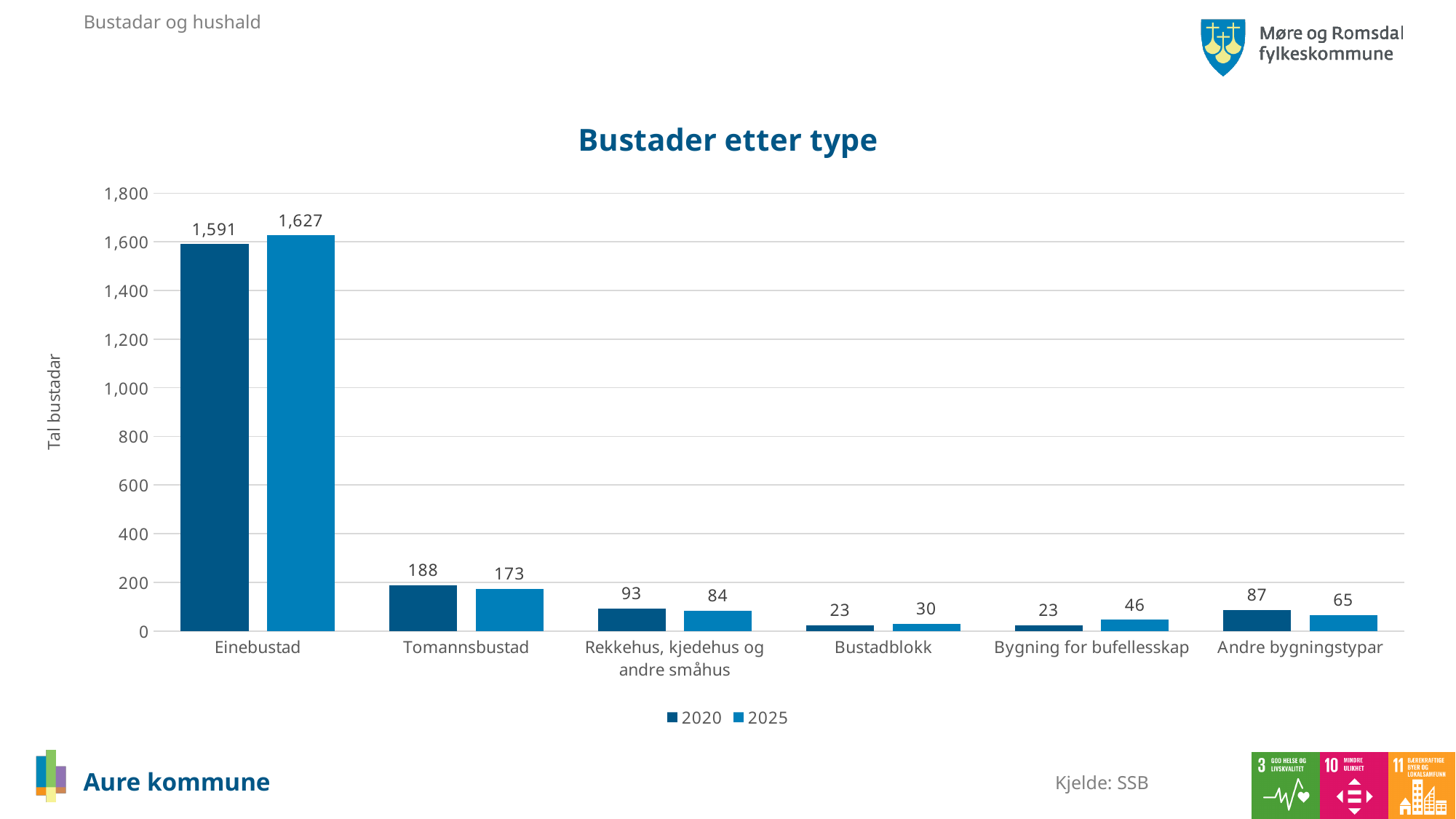
Which category has the highest value in 2020? Einebustad How many series does the legend list? 2 What is the difference between the 2025 and 2020 values for Einebustad? 36 How many categories are shown on the x axis? 6 What is the value for Bygning for bufellesskap in 2025? 46 What is the value for Einebustad in 2025? 1,627 What is the value for Tomannsbustad in 2020? 188 Which is larger for Andre bygningstypar: the 2020 value or the 2025 value? 2020 What is the title of the chart? Bustader etter type What kind of chart is shown? bar chart Which category has the lowest value in 2025? Bustadblokk Is the 2020 value for Tomannsbustad greater or less than 200? less